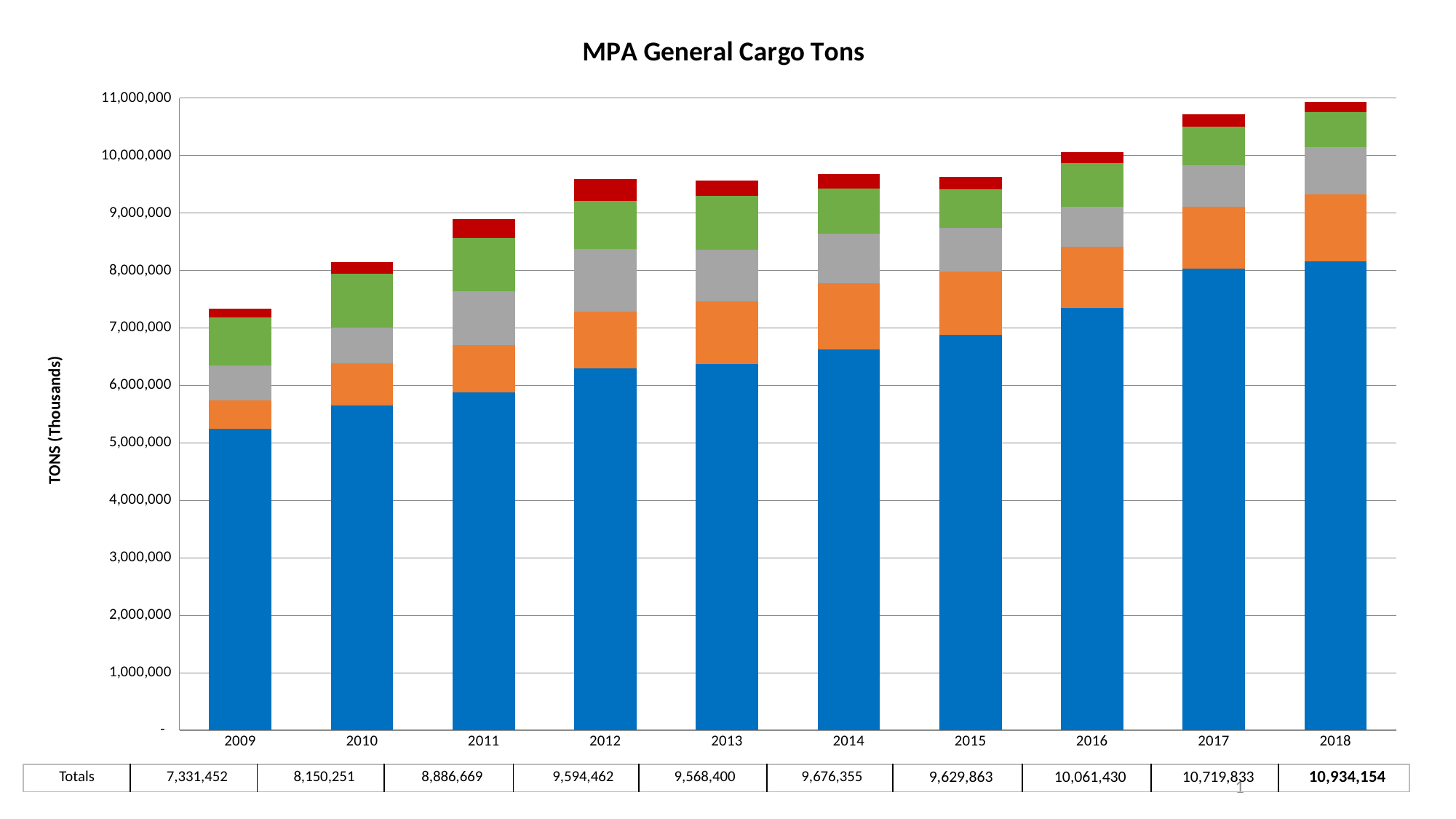
Is the blue segment for 2018 greater or less than 8,000,000? greater What is the total for 2009 shown in the Totals row? 7,331,452 What is the title of the chart? MPA General Cargo Tons What is the difference between the 2018 total and the 2009 total? 3,602,702 Which year has the larger total, 2012 or 2013? 2012 How many years are shown on the x axis of the chart? 10 Which year has the highest total? 2018 Do the totals generally rise or fall from 2009 to 2018? Rise Which year has the lowest total? 2009 What is the difference between the 2017 total and the 2016 total? 658,403 What is the total for 2016 shown in the Totals row? 10,061,430 What kind of chart is shown on the slide? Stacked bar chart